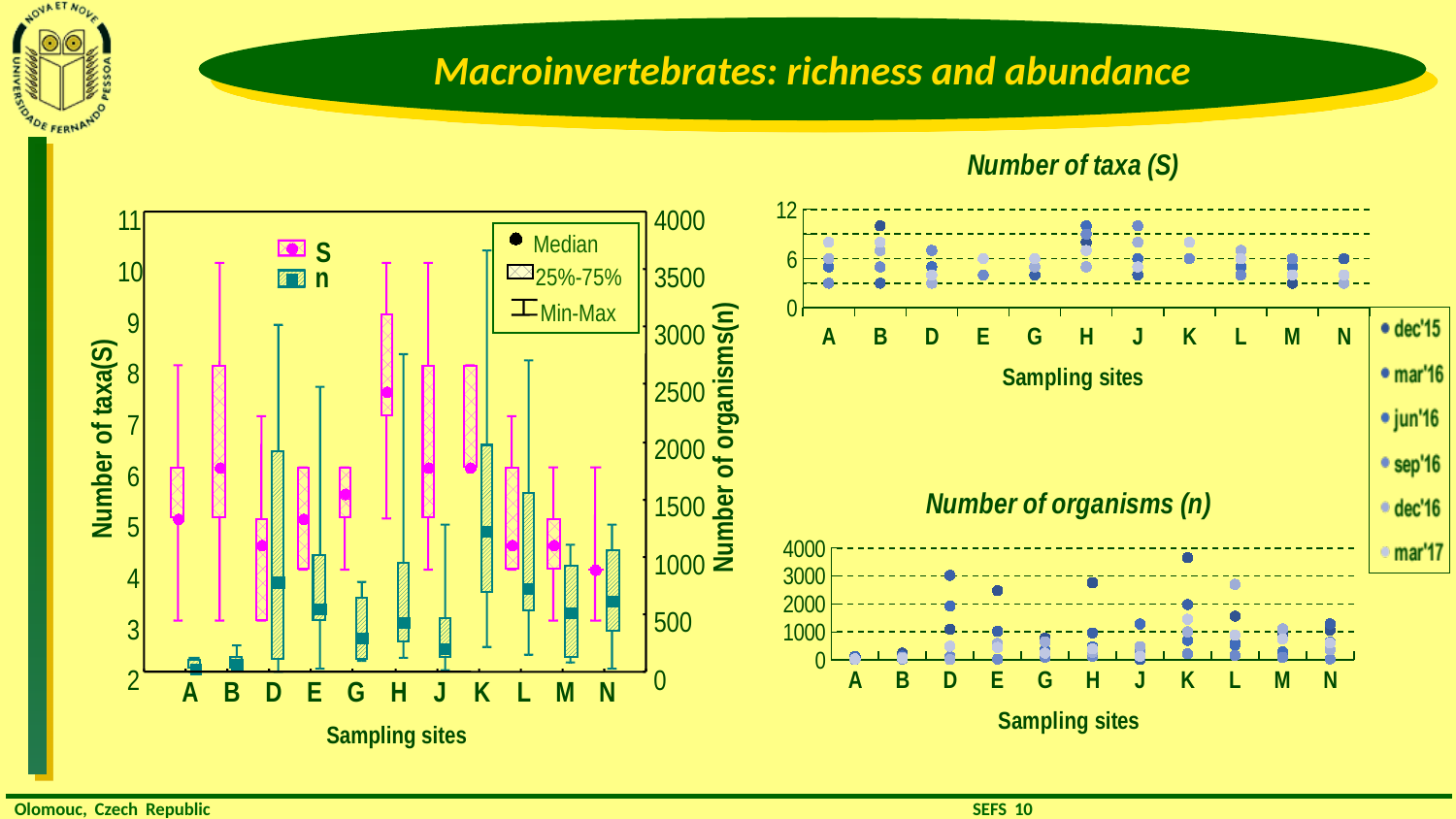
In the 'Number of organisms (n)' chart, is the highest value for site K greater or less than 3000? greater In the left box plot, which sampling site has the highest median number of taxa (S)? H In the 'Number of taxa (S)' chart, is the highest value for site A greater or less than 9? less What kind of chart is the left chart showing S and n? box plot In the 'Number of organisms (n)' chart, are all the values for site A greater or less than 1000? less In the left box plot, how many sampling sites are shown on the x axis? 11 In the 'Number of taxa (S)' chart on the right, how many sampling dates does the legend list? 6 What is the label of the x axis on the left box plot? Sampling sites